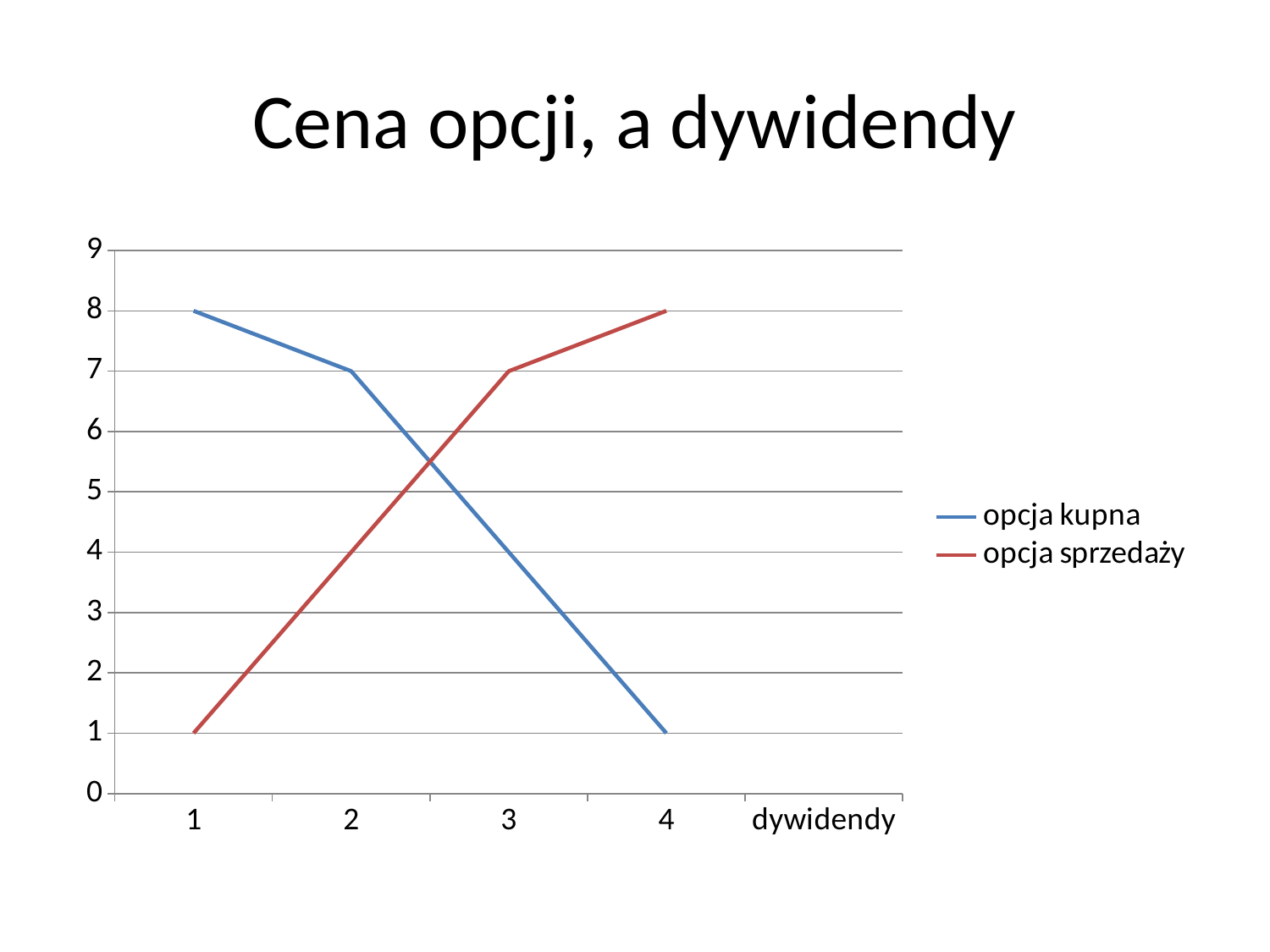
At which dywidendy value is opcja kupna highest? 1 What is the title of the chart on the slide? Cena opcji, a dywidendy What is the value of opcja sprzedaży at dywidendy 4? 8 Does the opcja kupna line rise or fall as dywidendy increases from 1 to 4? fall What is the value of opcja kupna at dywidendy 1? 8 What is the value of opcja sprzedaży at dywidendy 2? 4 At which dywidendy value is opcja sprzedaży lowest? 1 How many series does the legend list? 2 Which series has the larger value at dywidendy 3, opcja kupna or opcja sprzedaży? opcja sprzedaży What is the difference between opcja kupna and opcja sprzedaży at dywidendy 1? 7 What is the value of opcja kupna at dywidendy 4? 1 What type of chart is shown on the slide? line chart